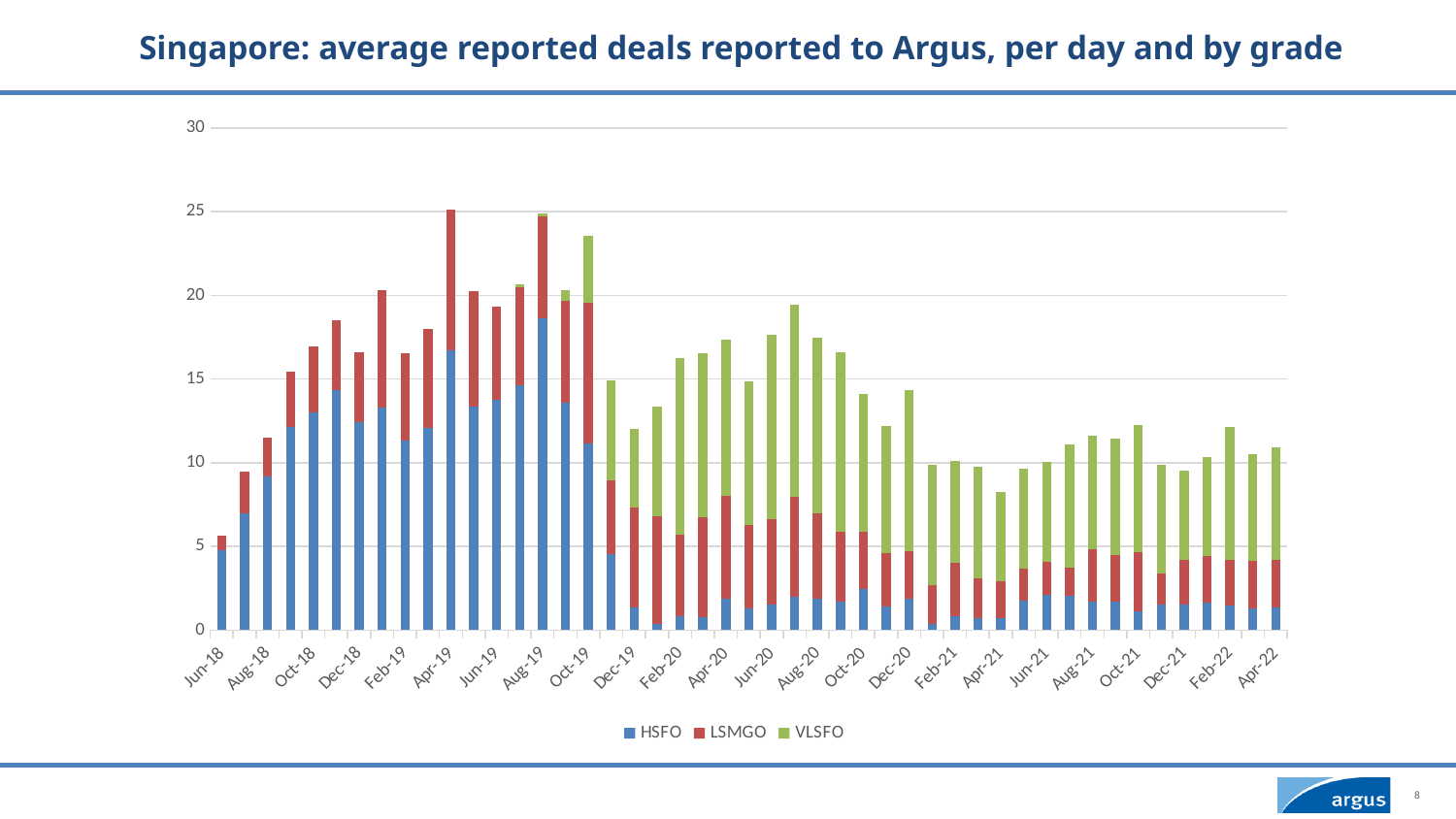
What kind of chart is shown on the slide? Stacked bar chart Is the total bar height for Apr-19 greater or less than 20? greater Which month has the larger total bar, Jun-18 or Oct-18? Oct-18 Is the total bar height for Apr-22 greater or less than 15? less Which month has the larger total bar, Apr-19 or Apr-22? Apr-19 How many series does the legend list? 3 What is the title of the chart? Singapore: average reported deals reported to Argus, per day and by grade Which series is shown in green in the legend? VLSFO Do the total bar heights generally rise or fall from Jun-18 to Apr-19? rise Is the HSFO value for Aug-19 greater or less than 15? greater